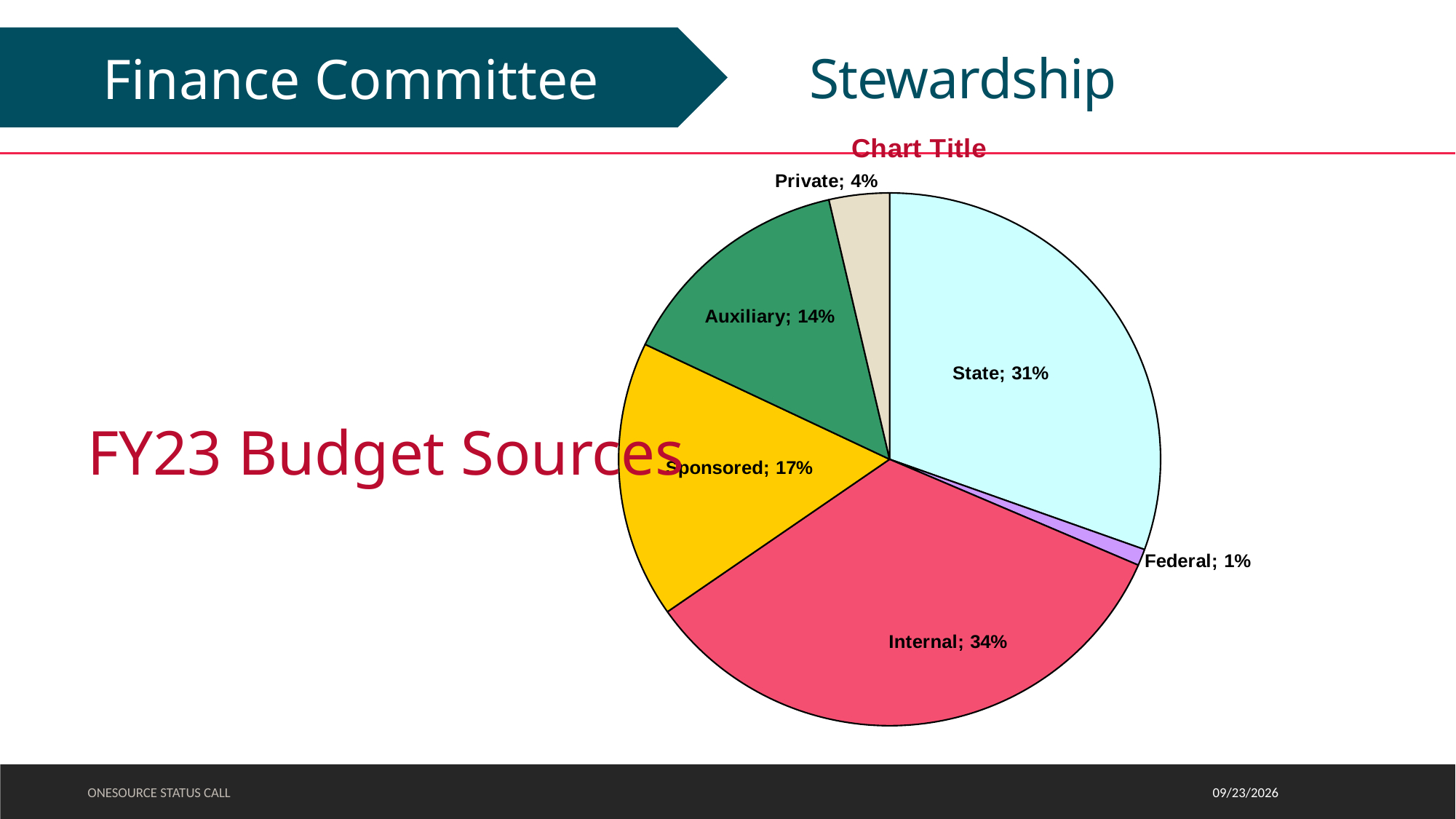
What share of the pie does Internal represent? 34% What share of the pie does Federal represent? 1% Which category has the smallest slice of the pie? Federal Which is larger, Sponsored or Auxiliary? Sponsored What share of the pie does Private represent? 4% Which category has the largest slice of the pie? Internal What share of the pie does Auxiliary represent? 14% What share of the pie does State represent? 31% What is the difference in percentage points between Internal and State? 3 How many slices does the pie chart have? 6 What type of chart is shown on the slide? pie chart What share of the pie does Sponsored represent? 17%